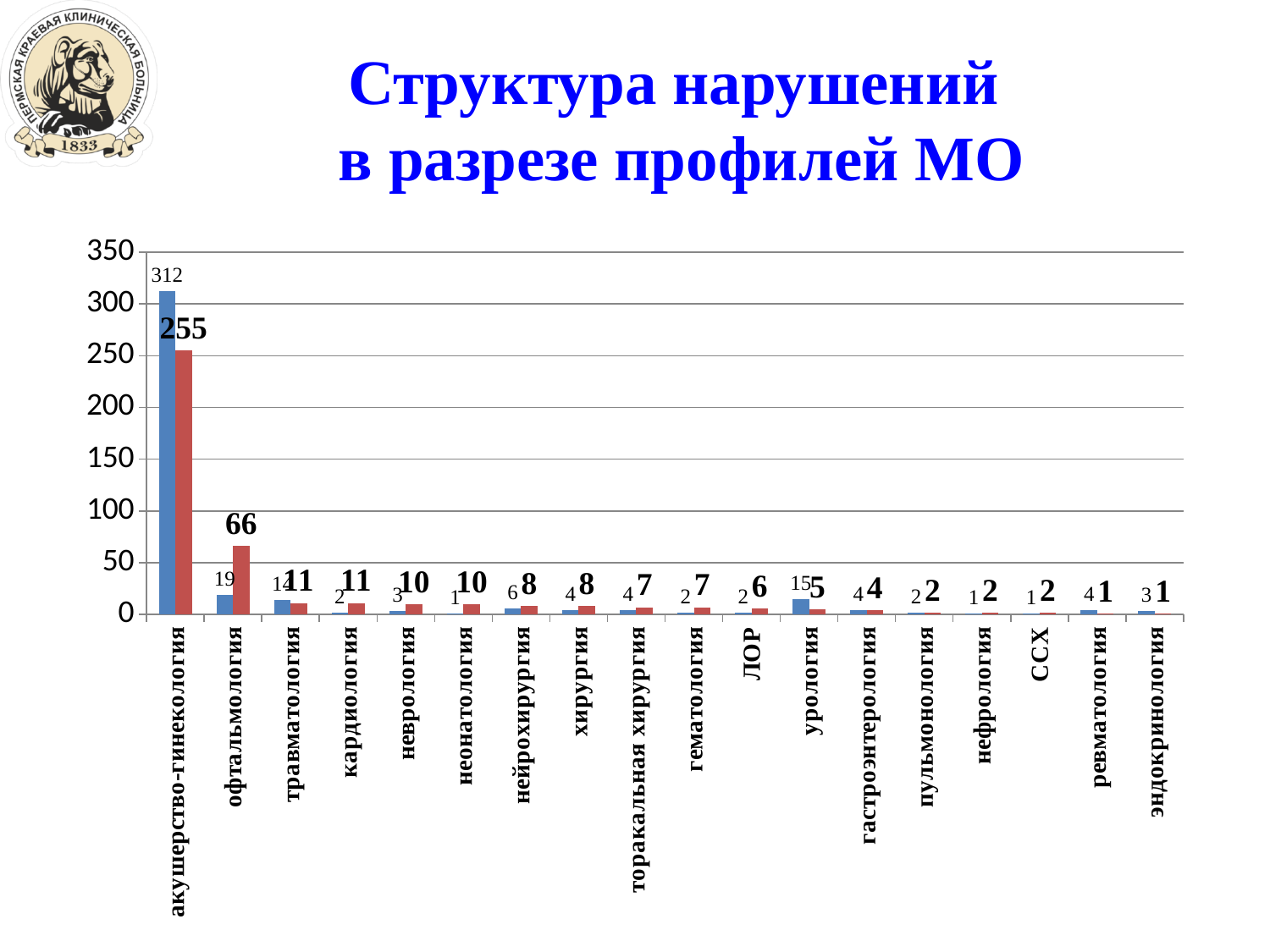
Is the value of the blue bar for акушерство-гинекология greater or less than 300? greater What is the title of the slide? Структура нарушений в разрезе профилей МО What is the value of the red bar for акушерство-гинекология? 255 What is the difference between the red bars for офтальмология and травматология? 55 Which is larger for офтальмология: the blue bar or the red bar? the red bar What is the value of the blue bar for урология? 15 What type of chart is shown on the slide? bar chart What is the value of the red bar for офтальмология? 66 What is the value of the blue bar for акушерство-гинекология? 312 How many categories (profiles) are shown on the x axis of the chart? 18 Which category has the highest blue bar? акушерство-гинекология What is the difference between the blue and red bars for акушерство-гинекология? 57